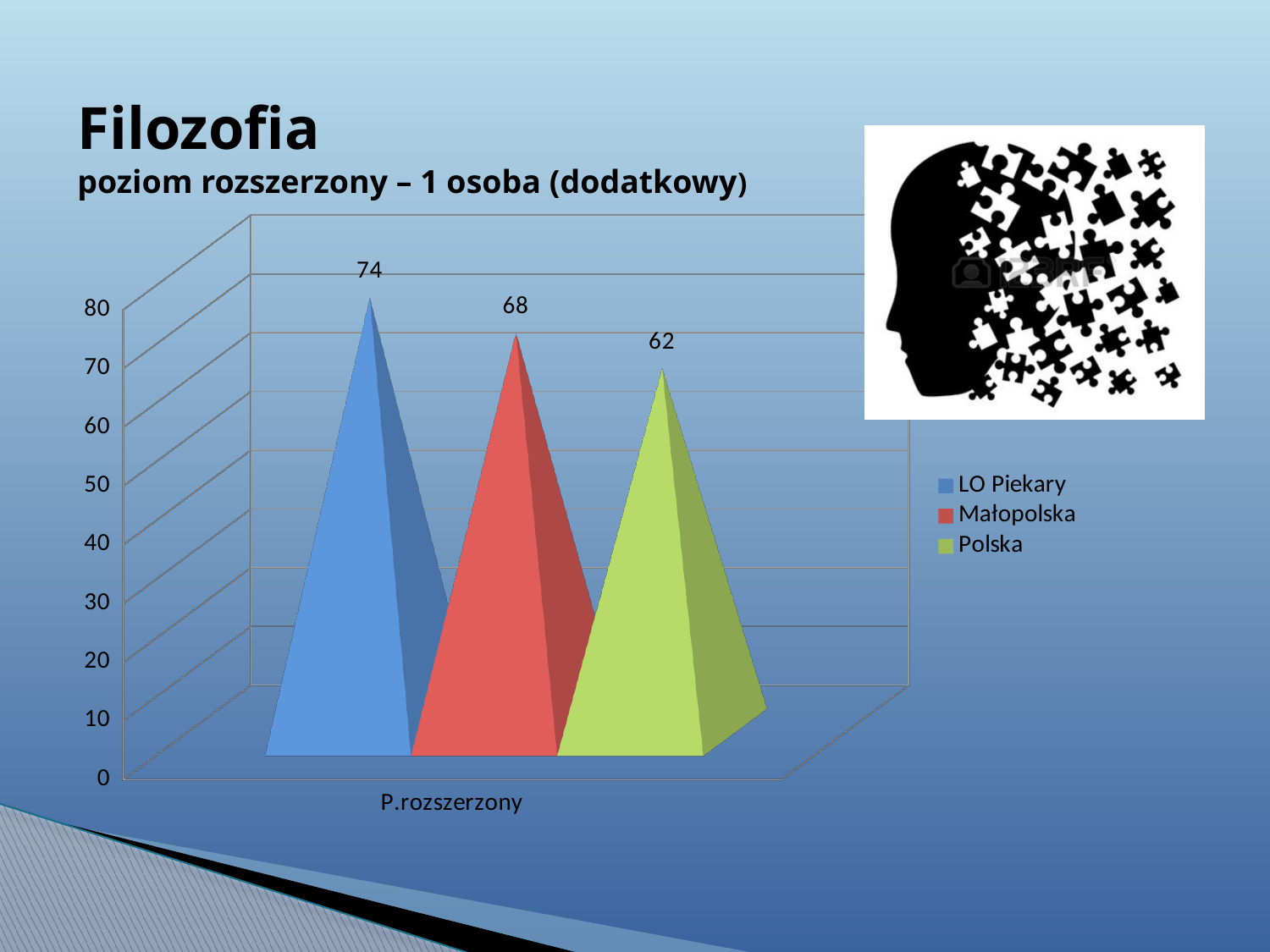
Which is larger, the value for LO Piekary or the value for Małopolska? LO Piekary What is the value for Małopolska? 68 What colour represents Małopolska in the chart? Red Is the value for Polska greater or less than 70? less What is the category label shown on the x axis? P.rozszerzony Which series has the lowest value? Polska What is the difference between the values for LO Piekary and Polska? 12 What is the difference between the values for Małopolska and Polska? 6 How many series does the legend list? 3 Which series has the highest value? LO Piekary What is the value for Polska? 62 What is the value for LO Piekary? 74